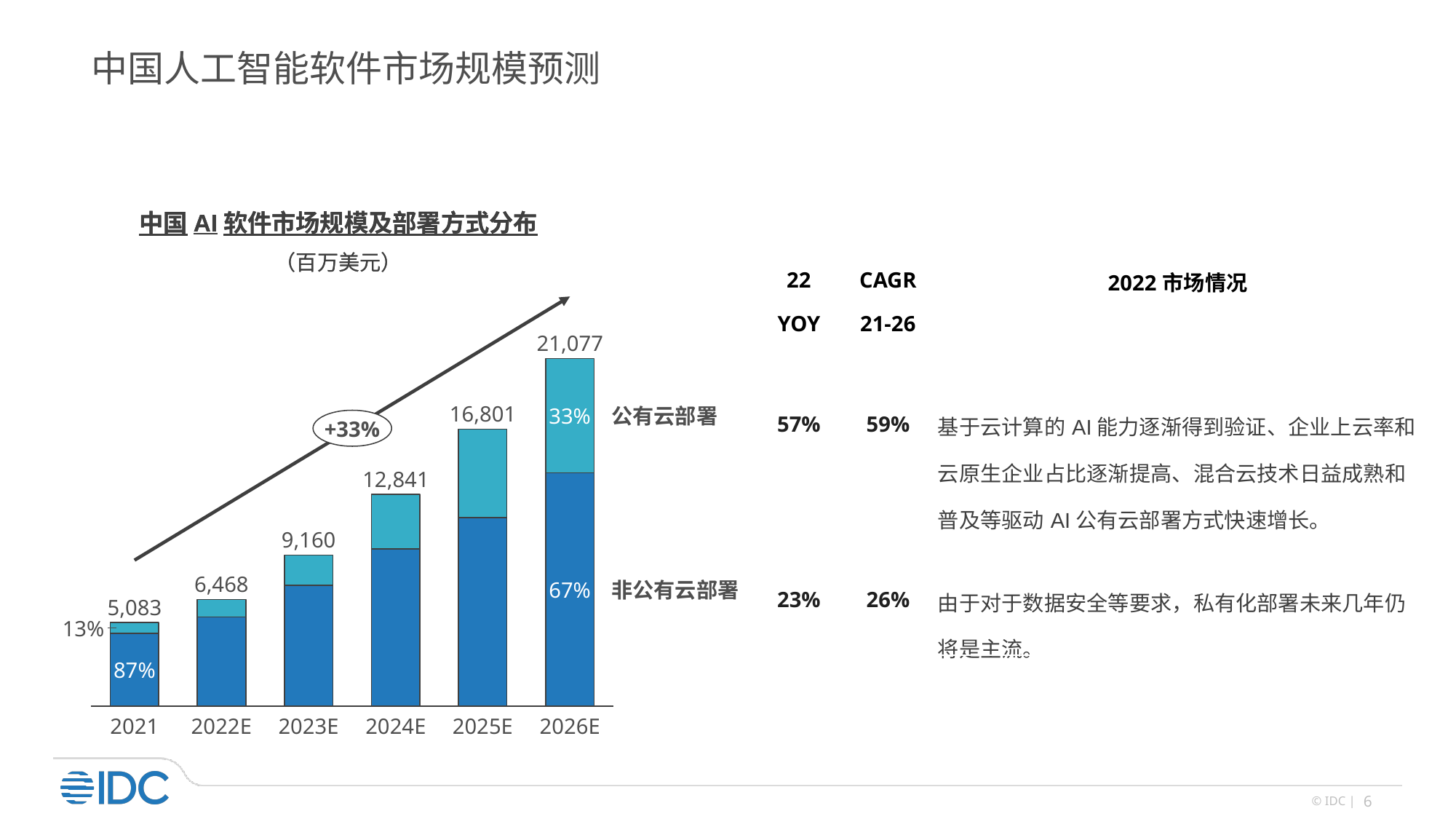
Which year has the lowest total market size? 2021 What is the difference between the total for 2026E and the total for 2021? 15,994 How many years are shown on the x axis of the chart? 6 What is the total market size shown for 2026E? 21,077 What CAGR is shown in the circle on the arrow above the bars? +33% What share of the 2021 bar is 非公有云部署? 87% What is the total market size shown for 2021? 5,083 What is the total market size shown for 2024E? 12,841 What is the difference between the total for 2025E and the total for 2024E? 3,960 What share of the 2026E bar is 公有云部署? 33% What kind of chart is used to show the market size? Stacked bar chart Which year has the highest total market size? 2026E